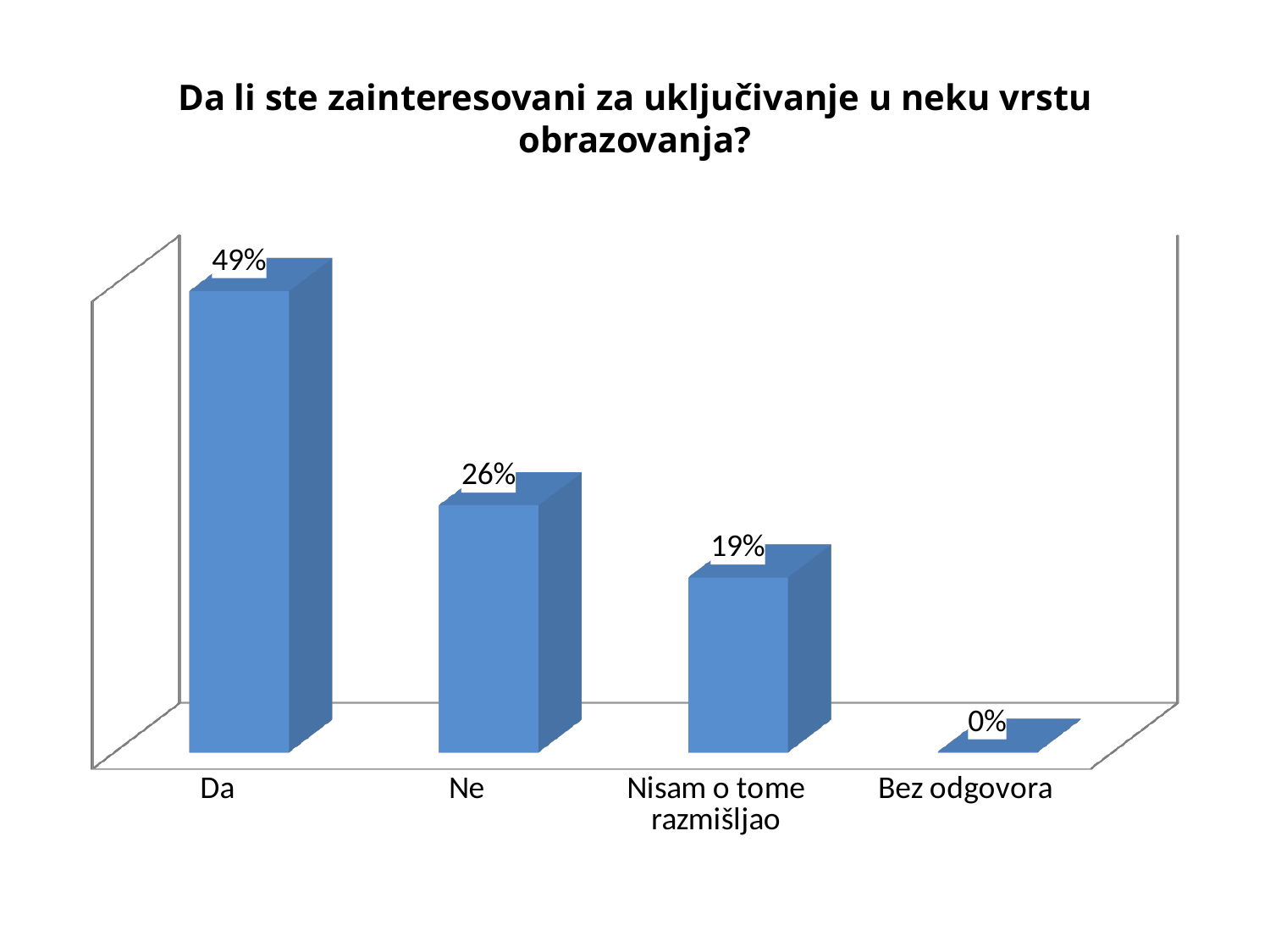
What is the difference between the values for "Ne" and "Nisam o tome razmišljao"? 7% What is the value for "Nisam o tome razmišljao"? 19% What is the value for "Da"? 49% What is the value for "Bez odgovora"? 0% What is the difference between the values for "Da" and "Ne"? 23% What kind of chart is shown on the slide? Bar chart Which is larger, the value for "Ne" or the value for "Nisam o tome razmišljao"? Ne What is the title of the chart? Da li ste zainteresovani za uključivanje u neku vrstu obrazovanja? What is the value for "Ne"? 26% Which category has the highest value? Da How many categories are shown on the chart? 4 Which category has the lowest value? Bez odgovora